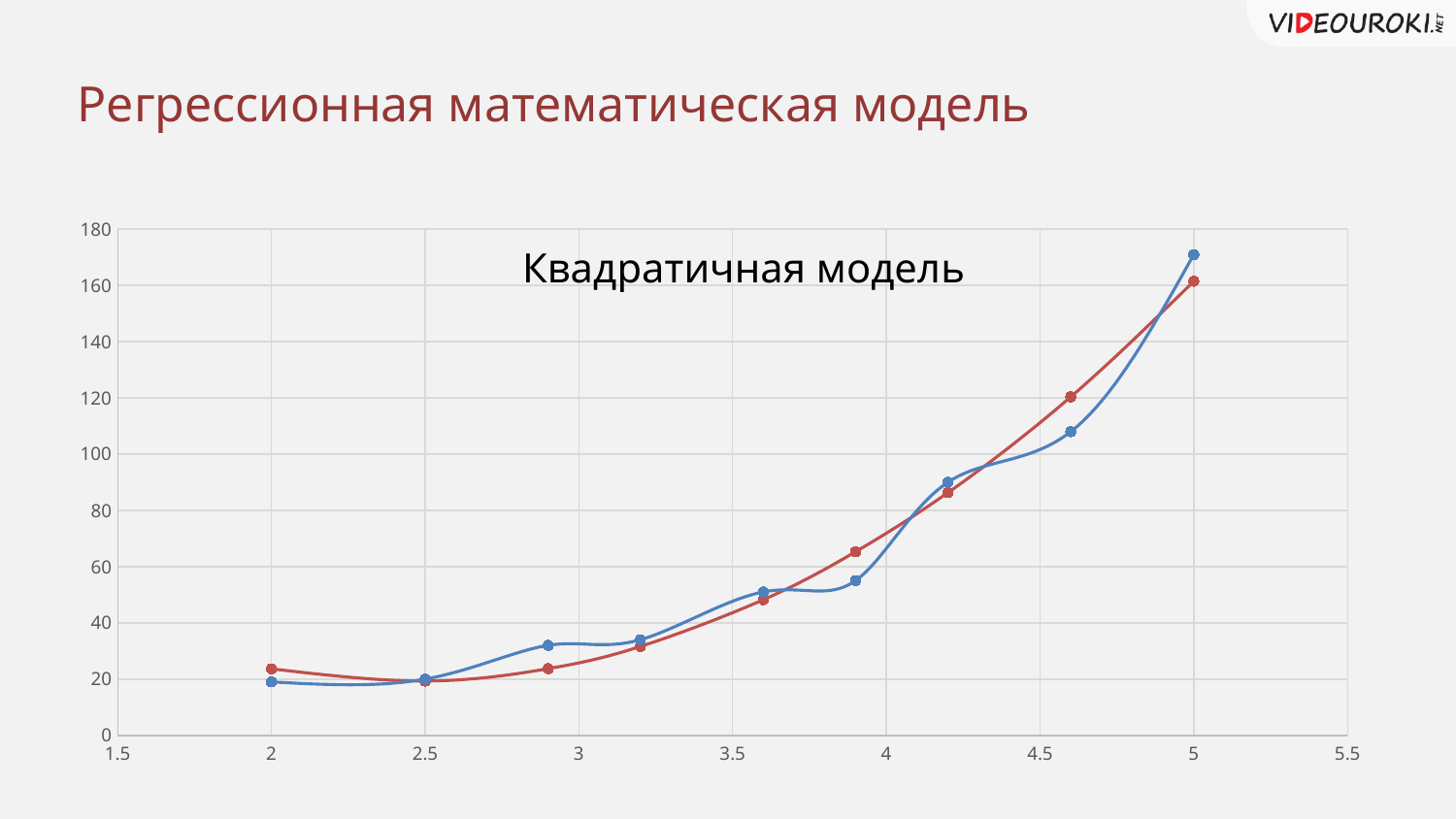
Do the values of the red series generally rise or fall as x increases from 2 to 5? rise Is the value of the blue series at x = 5 greater or less than 160? greater How many data series are plotted on the chart? 2 How many data points does the blue series have? 9 At x = 5, which series has the higher value, the blue or the red? blue Is the value of the blue series at x = 3.9 greater or less than 60? less At x = 4.6, which series has the higher value, the blue or the red? red Is the value of the red series at x = 3.9 greater or less than 60? greater What kind of chart is shown on the slide? line chart What is the title printed inside the chart area? Квадратичная модель At which x value does the blue series reach its highest point? 5